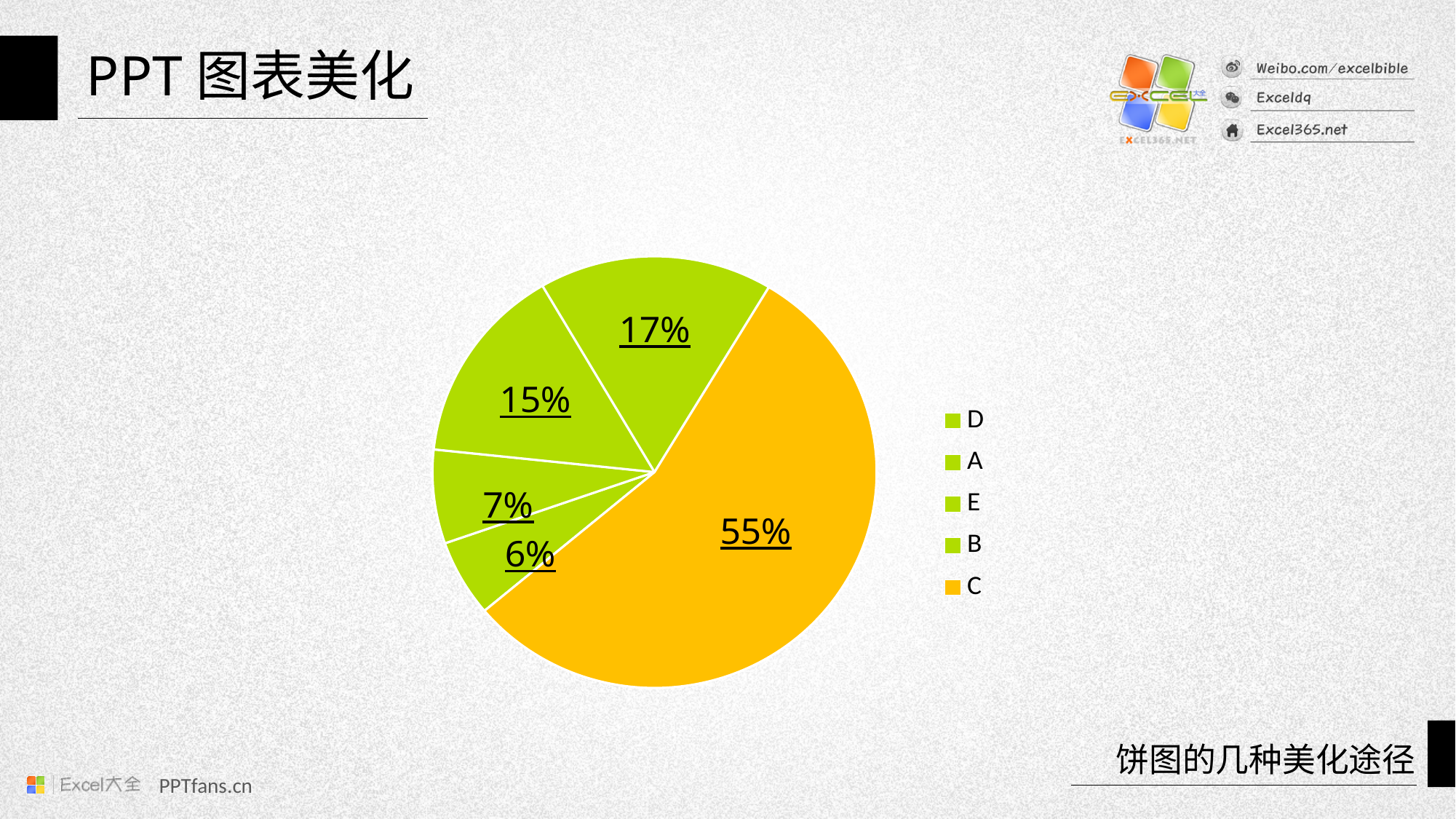
What colour is the slice for legend entry C? orange What are the legend entries, in order from top to bottom? D, A, E, B, C Which is larger, the slice labelled 7% or the slice labelled 6%? 7% Is the share of the orange slice greater or less than 50%? greater What is the smallest percentage shown on the pie chart? 6% What is the largest percentage shown on the pie chart? 55% What is the difference between the 17% slice and the 15% slice? 2 percentage points What share of the pie does the orange slice (C) represent? 55% How many slices does the pie chart have? 5 What kind of chart is shown on the slide? pie chart How many entries does the legend list? 5 What is the combined share of all the green slices? 45%